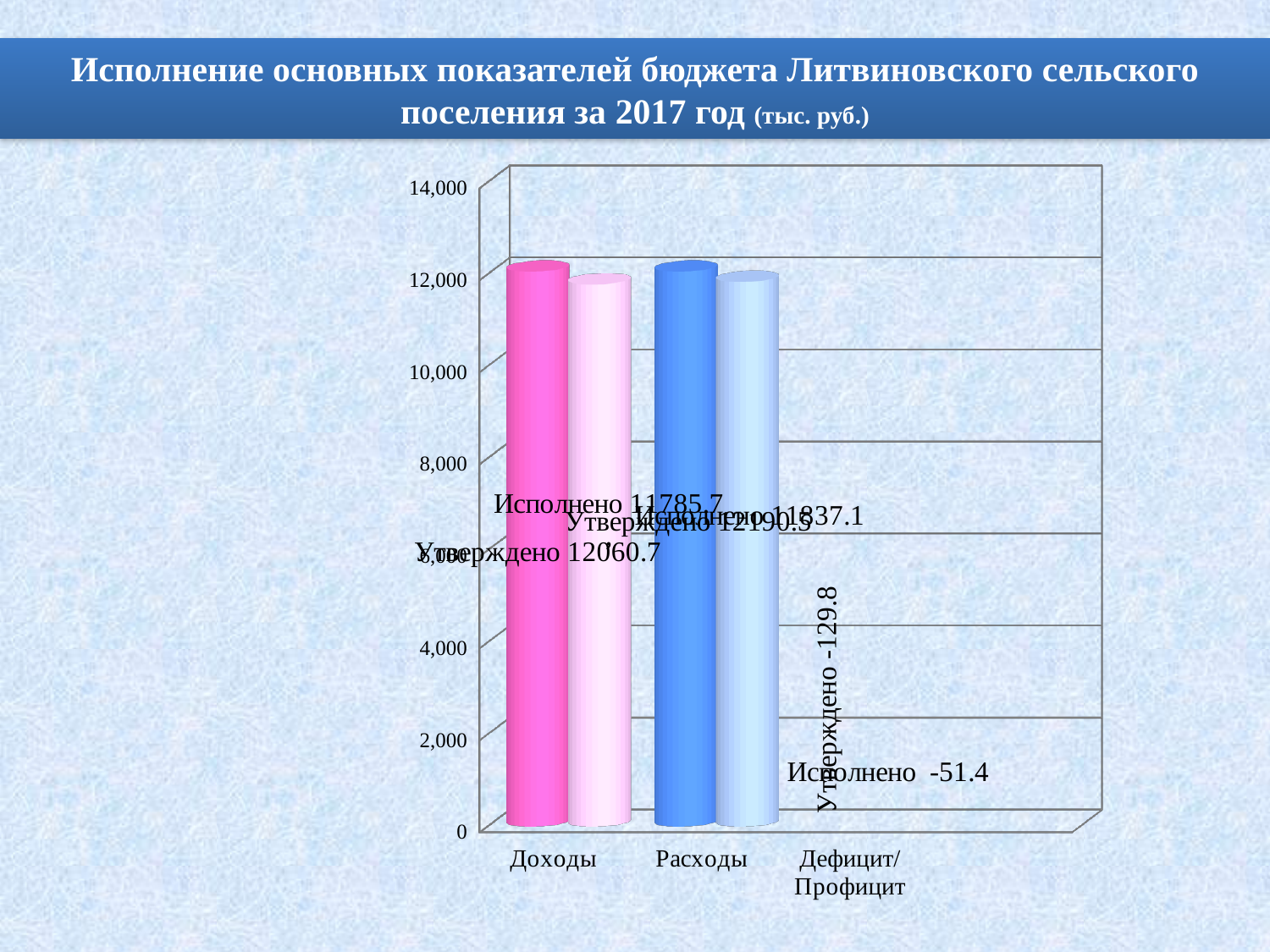
Is the approved (Утверждено) value for Расходы greater or less than 12,000? greater Is the executed (Исполнено) value for Доходы greater or less than 12,000? less What is the executed (Исполнено) value for Доходы? 11785.7 How many categories are shown on the x axis of the chart? 3 What is the difference between the approved and executed values for Доходы? 275.0 What is the approved (Утверждено) value for Дефицит/Профицит? -129.8 What is the executed (Исполнено) value for Расходы? 11837.1 What is the approved (Утверждено) value for Доходы? 12060.7 Which is larger for Доходы: the approved (Утверждено) value or the executed (Исполнено) value? Утверждено What kind of chart is shown on the slide? bar chart In what units are the values on the chart expressed, according to the slide title? тыс. руб. What is the executed (Исполнено) value for Дефицит/Профицит? -51.4